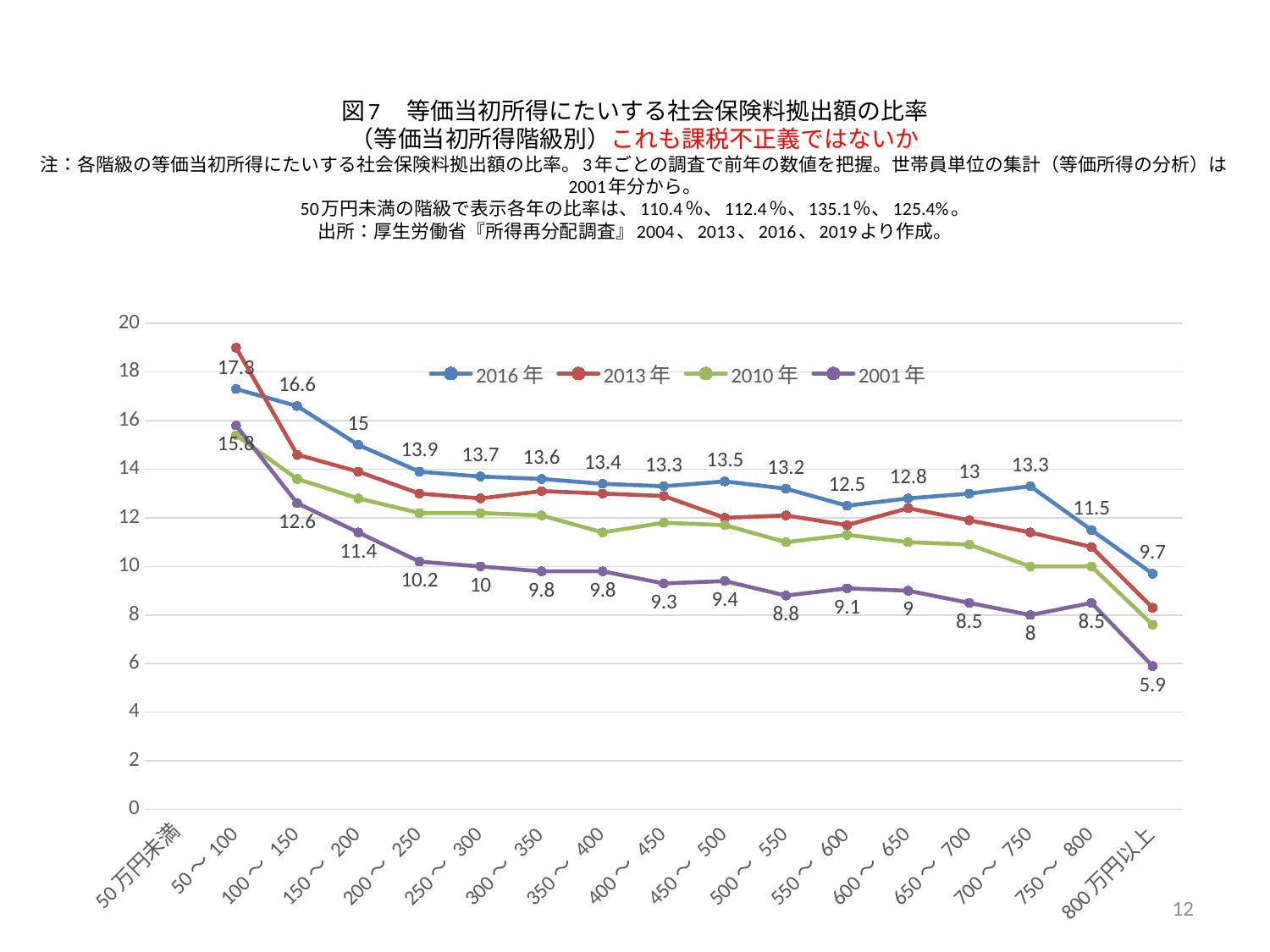
Is the value of the 2013年 series for the 50～100 category greater or less than 18? greater Do the values of the 2001年 series generally rise or fall from left to right along the x axis? fall What is the value of the 2001年 series for the 800万円以上 category? 5.9 What kind of chart is shown on the slide? line chart For the 2016年 series, which is larger: the value for 700～750 or for 750～800? 700～750 Is the value of the 2010年 series for the 800万円以上 category greater or less than 8? less What is the difference between the 2016年 and 2001年 values for the 50～100 category? 1.5 Which category has the highest value for the 2016年 series? 50～100 What is the value of the 2016年 series for the 100～150 category? 16.6 What is the value of the 2001年 series for the 700～750 category? 8 Which category has the lowest value for the 2001年 series? 800万円以上 How many series does the legend list? 4